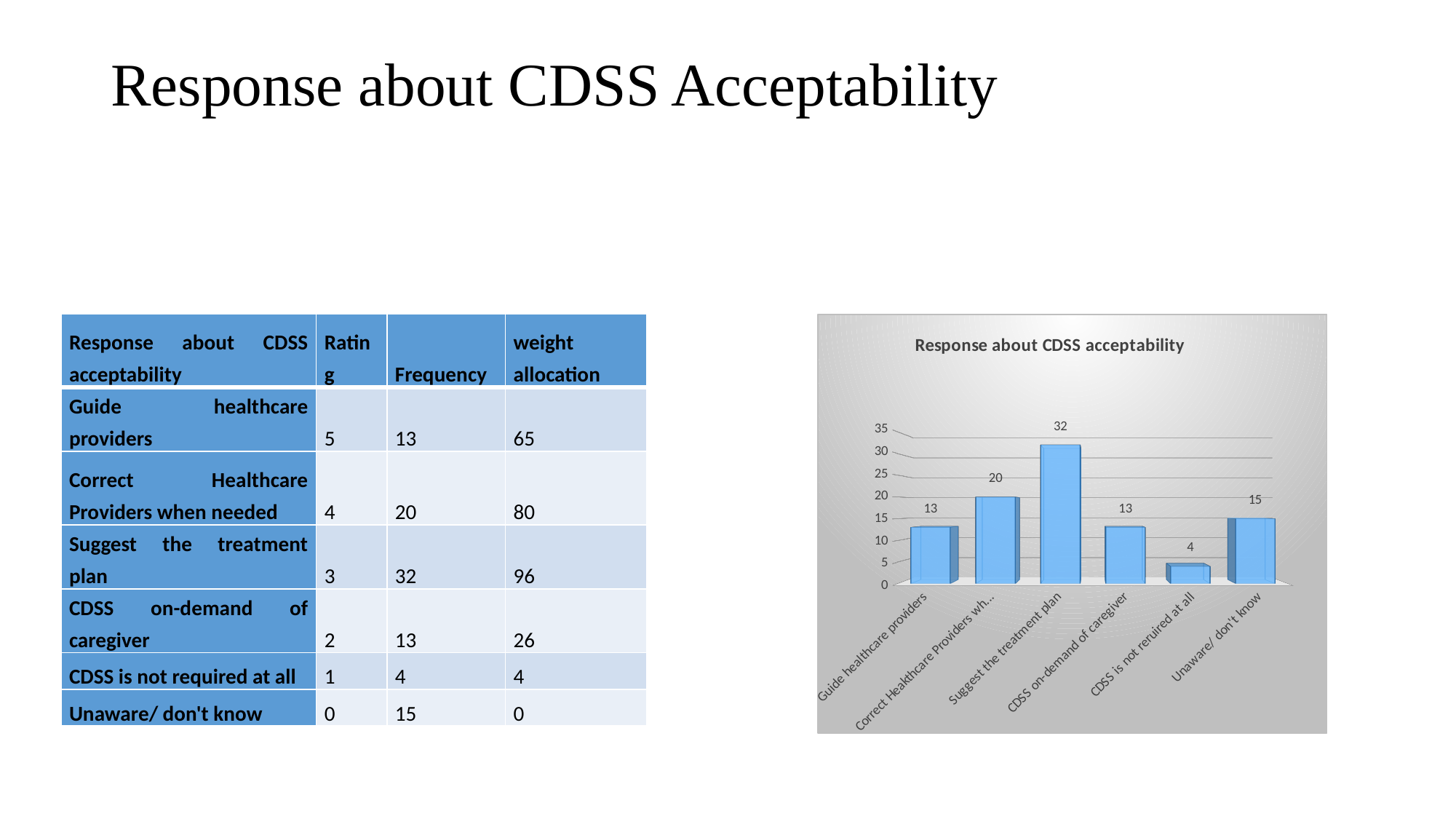
What is the title of the chart? Response about CDSS acceptability Which is larger in the chart: the value for "Unaware/ don't know" or the value for "CDSS on-demand of caregiver"? Unaware/ don't know What is the value for "Unaware/ don't know" in the chart? 15 What is the value for "Suggest the treatment plan" in the chart? 32 Which category has the lowest value in the chart? CDSS is not reruired at all What is the difference between the values for "Suggest the treatment plan" and "Unaware/ don't know"? 17 What is the value for "CDSS on-demand of caregiver" in the chart? 13 How many categories are plotted in the chart? 6 Which category has the highest value in the chart? Suggest the treatment plan Is the value for "Suggest the treatment plan" greater or less than 30? greater What type of chart is shown on the slide? bar chart What is the value for "Guide healthcare providers" in the chart? 13